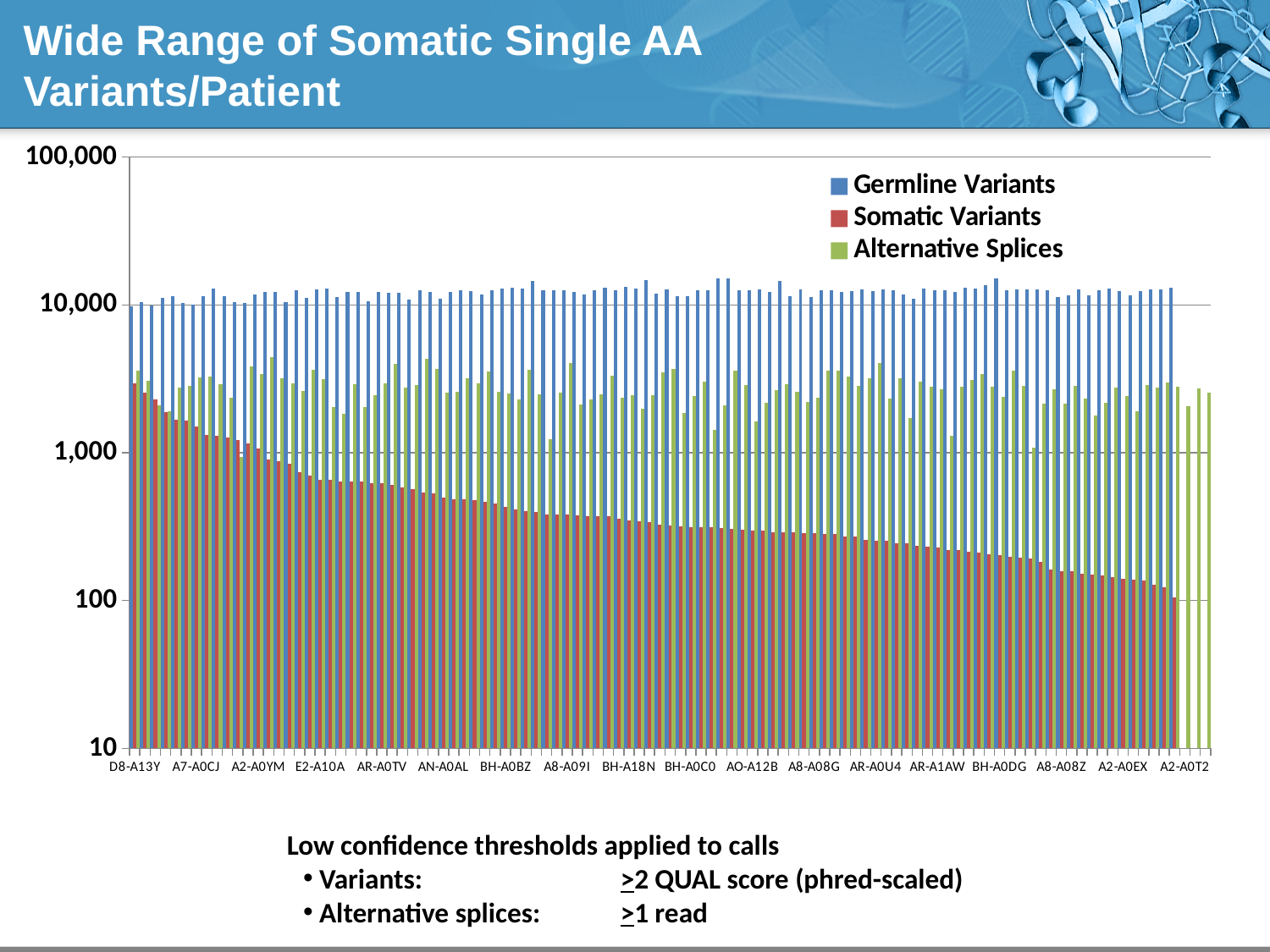
Is the Germline Variants value for D8-A13Y greater or less than 1,000? greater Is the Germline Variants value for BH-A0C0 greater or less than 1,000? greater Do the Somatic Variants values rise or fall moving left to right along the x axis? fall For D8-A13Y, which is larger: Germline Variants or Somatic Variants? Germline Variants How many series does the chart legend list? 3 Is the Somatic Variants value for A2-A0EX greater or less than 1,000? less For A2-A0EX, which is larger: Somatic Variants or Alternative Splices? Alternative Splices What kind of chart is shown on the slide? bar chart What is the highest value labelled on the chart's y axis? 100,000 What are the three series named in the chart legend? Germline Variants, Somatic Variants, Alternative Splices Which colour represents Somatic Variants in the chart? red